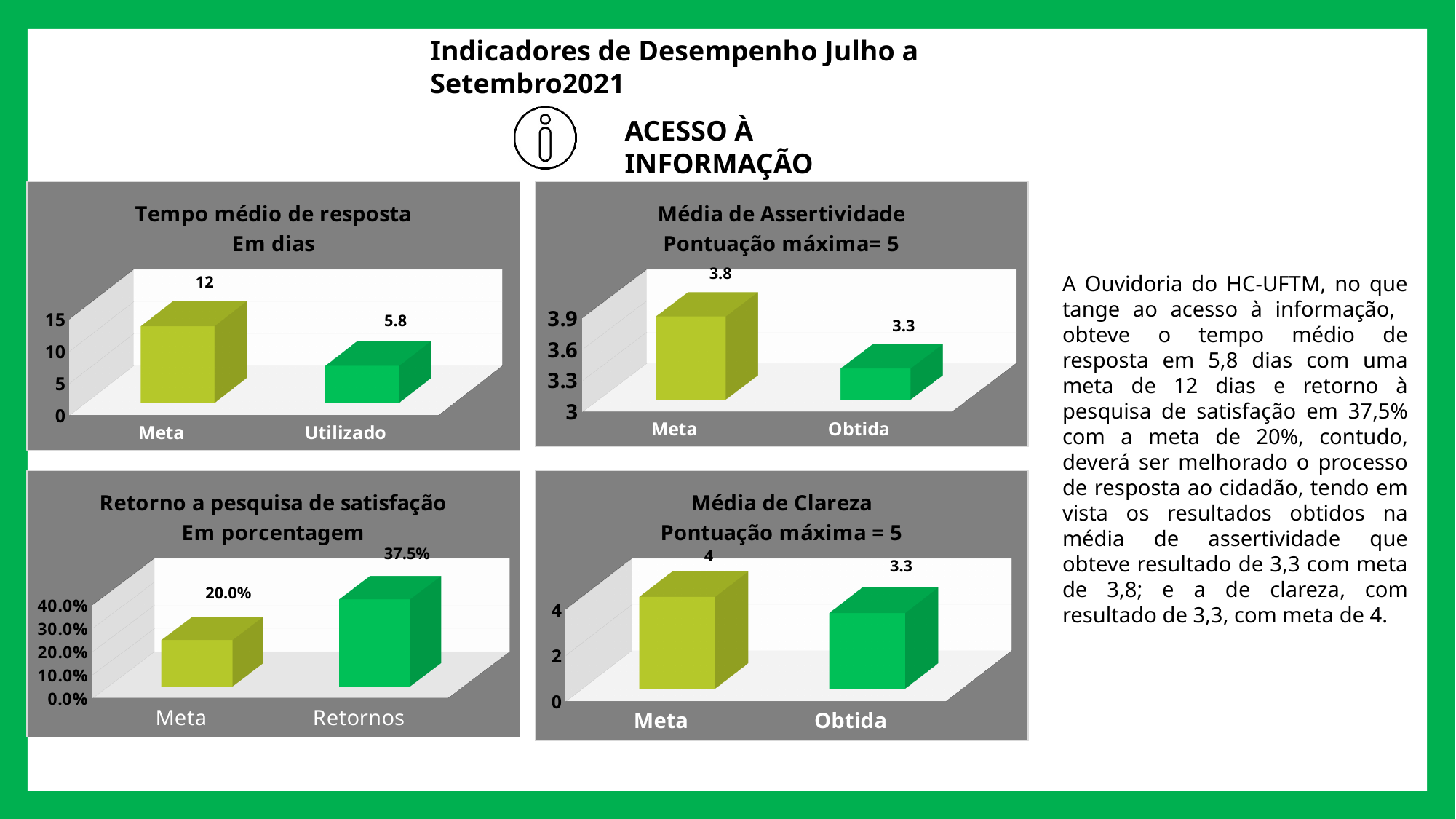
In the 'Média de Assertividade' chart, what is the value for Obtida? 3.3 In the 'Média de Clareza' chart, what is the value for Meta? 4 In the 'Tempo médio de resposta' chart, what is the value for Meta? 12 In the 'Retorno a pesquisa de satisfação' chart, what is the value for Retornos? 37.5% In the 'Média de Assertividade' chart, what is the difference between Meta and Obtida? 0.5 In the 'Tempo médio de resposta' chart, what is the value for Utilizado? 5.8 In the 'Média de Assertividade' chart, which category is higher, Meta or Obtida? Meta What type of chart is the 'Média de Clareza' chart? Bar chart In the 'Média de Clareza' chart, how many categories are shown? 2 In the 'Tempo médio de resposta' chart, what is the difference between Meta and Utilizado? 6.2 In the 'Retorno a pesquisa de satisfação' chart, which category has the lowest value? Meta In the 'Retorno a pesquisa de satisfação' chart, what is the difference between Retornos and Meta? 17.5%